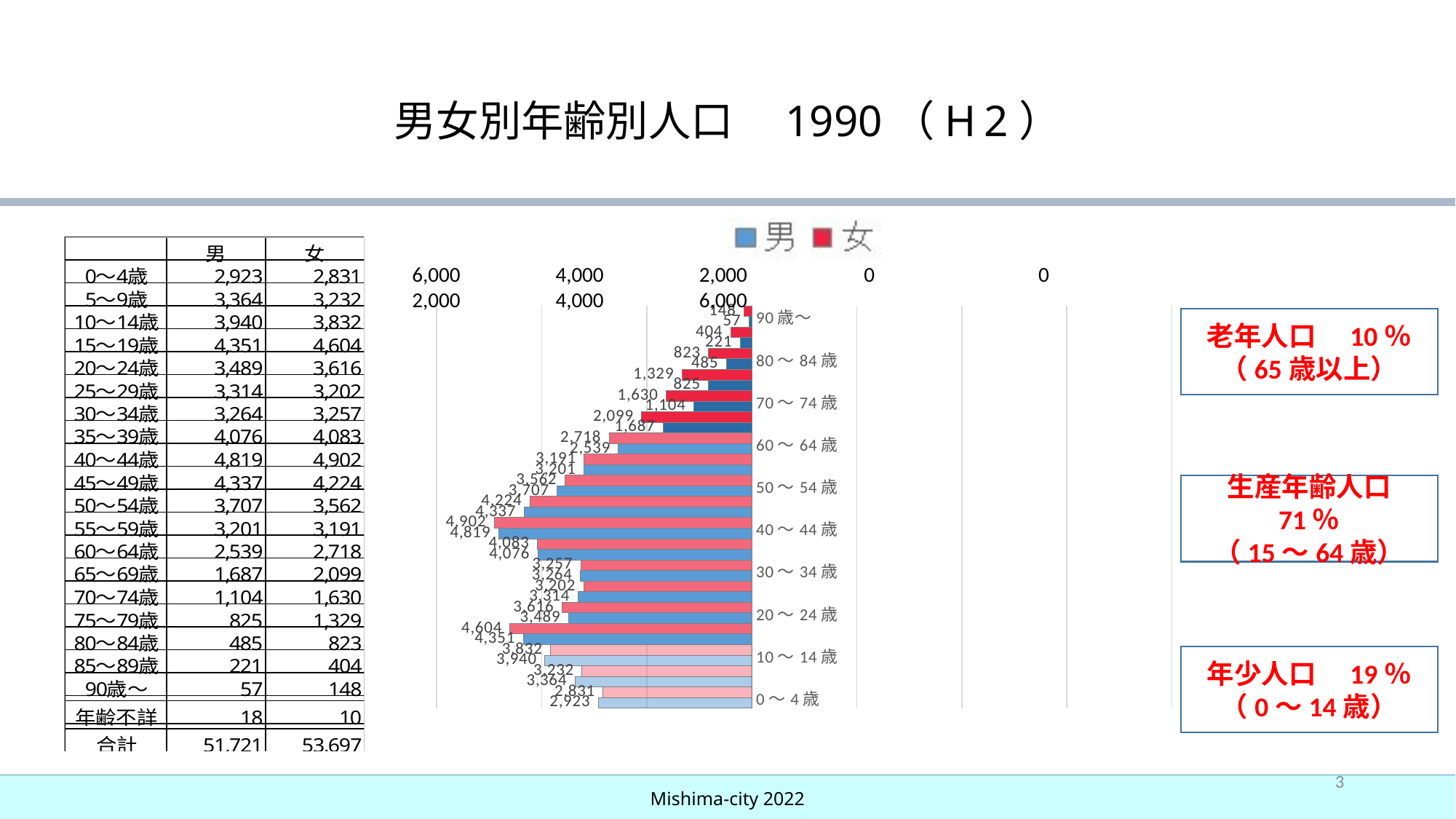
What is the value for 男 (male) in the 80〜84歳 age group? 485 What is the value for 女 (female) in the 90歳〜 age group? 148 How much larger is the 女 (female) value than the 男 (male) value in the 70〜74歳 age group? 526 Which age group has the highest value for 女 (female)? 40〜44歳 How many series does the legend list? 2 In the 15〜19歳 age group, which is larger, 男 (male) or 女 (female)? 女 What is the difference between the 女 (female) and 男 (male) values in the 40〜44歳 age group? 83 What are the two legend entries of the chart? 男 and 女 Which age group has the lowest value for 男 (male)? 90歳〜 How many age group categories are plotted in the chart? 19 What is the value for 男 (male) in the 40〜44歳 age group? 4,819 What kind of chart is shown on the slide? Bar chart